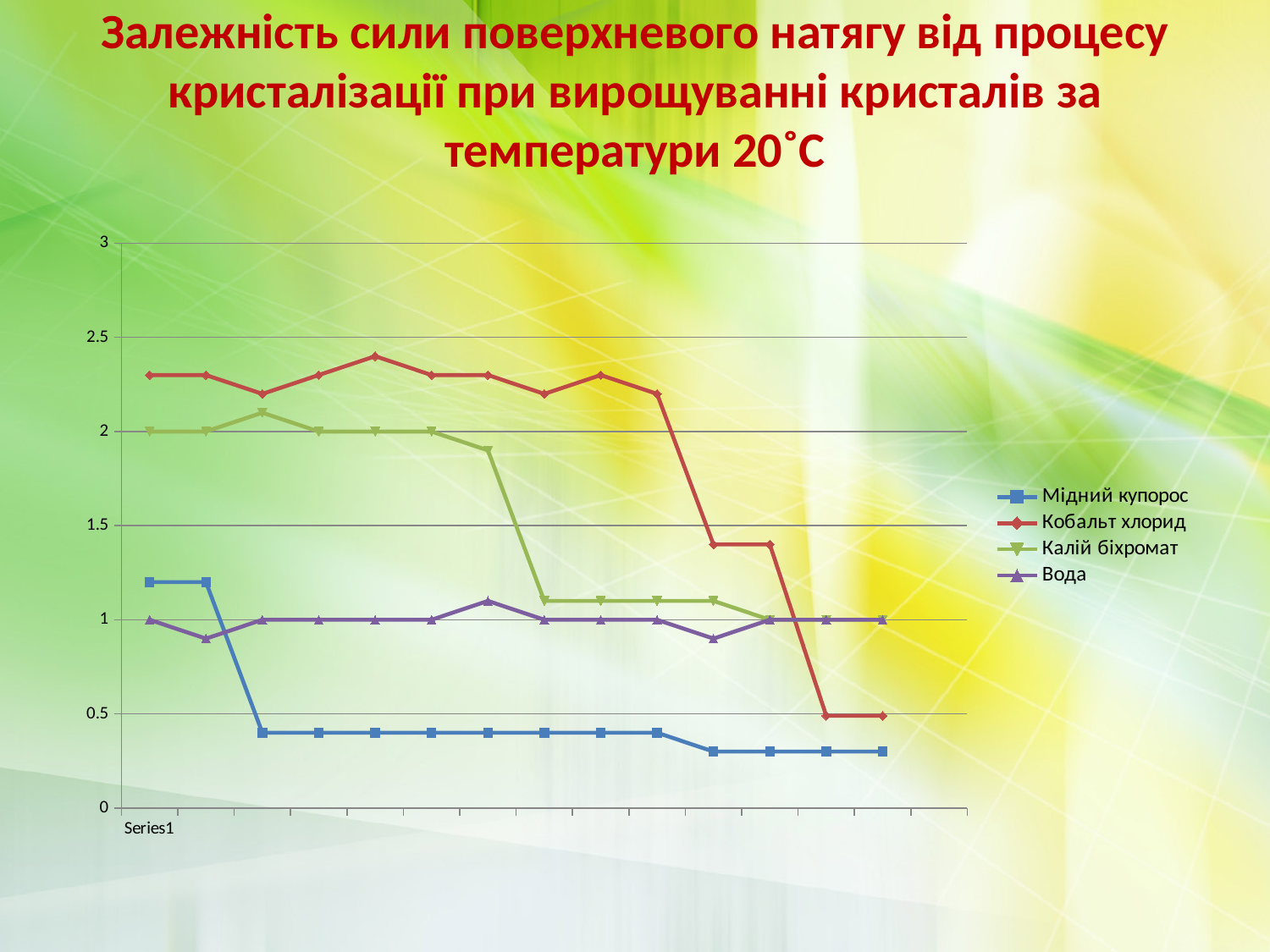
What is the value for Калій біхромат at the first point (Series1)? 2 Is the value for Мідний купорос at the last point greater or less than 0.5? less At the first point, which series has the highest value? Кобальт хлорид How many data points does each line have? 14 What is the value for Вода at the first point (Series1)? 1 What kind of chart is shown on the slide? line chart Which series are listed in the legend? Мідний купорос, Кобальт хлорид, Калій біхромат, Вода Does the Кобальт хлорид line overall rise or fall from left to right? fall Is the value for Кобальт хлорид at the first point greater or less than 2? greater At the first point, which is larger: Кобальт хлорид or Мідний купорос? Кобальт хлорид How many series does the legend list? 4 Is the value for Калій біхромат at the last point greater or less than 1.5? less